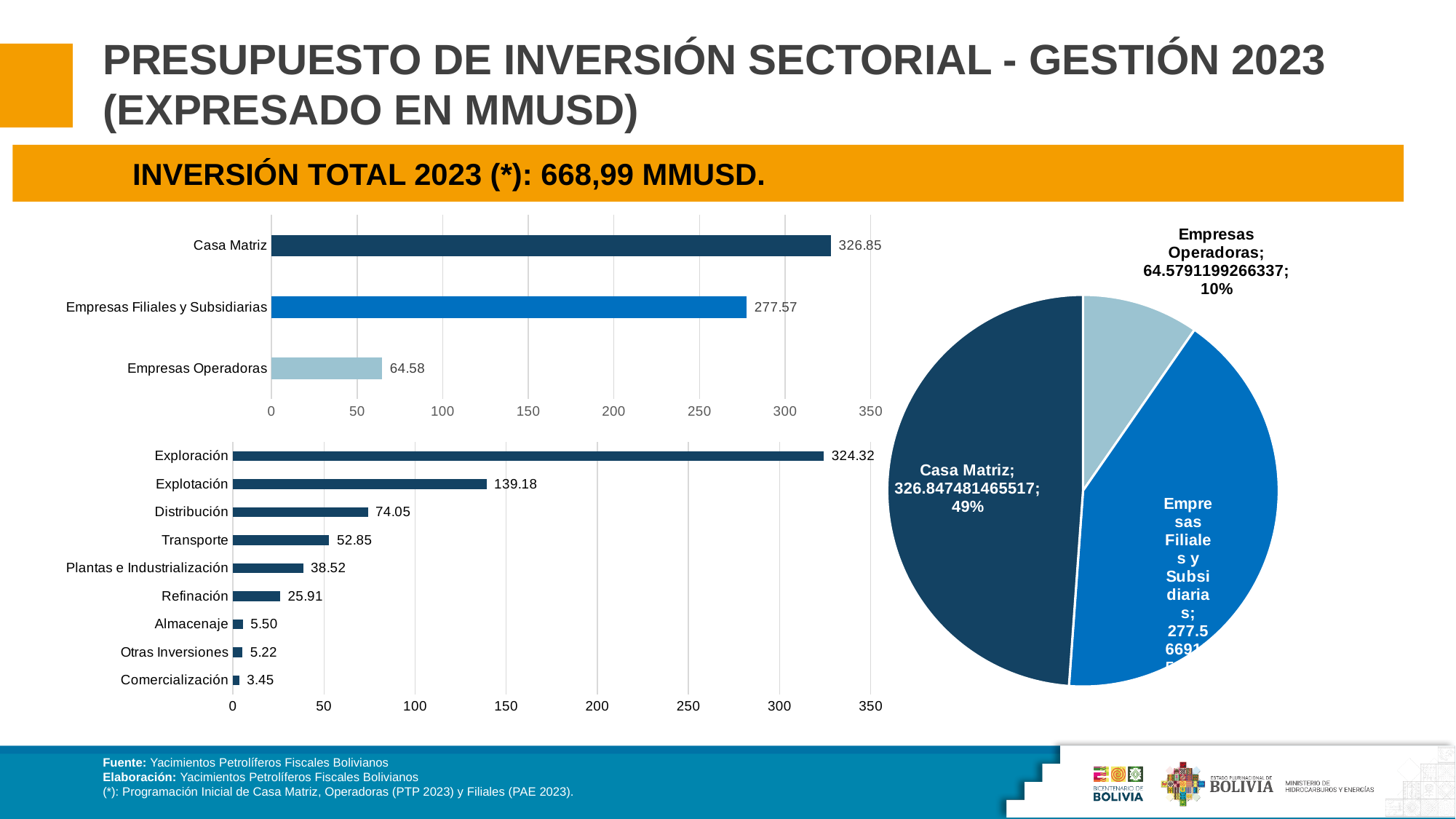
In the bottom-left bar chart, which is larger, Distribución or Transporte? Distribución In the top-left bar chart, how many categories are shown? 3 In the bottom-left bar chart, what is the difference between Refinación and Almacenaje? 20.41 In the bottom-left bar chart, which category has the highest value? Exploración In the top-left bar chart, what is the value for Empresas Operadoras? 64.58 What kind of chart is shown on the right side of the slide? Pie chart In the bottom-left bar chart, which category has the lowest value? Comercialización In the pie chart on the right, what share does Casa Matriz represent? 49% In the top-left bar chart, what is the value for Casa Matriz? 326.85 In the bottom-left bar chart, how many categories are shown? 9 In the bottom-left bar chart, what is the value for Explotación? 139.18 In the top-left bar chart, what is the difference between Casa Matriz and Empresas Filiales y Subsidiarias? 49.28